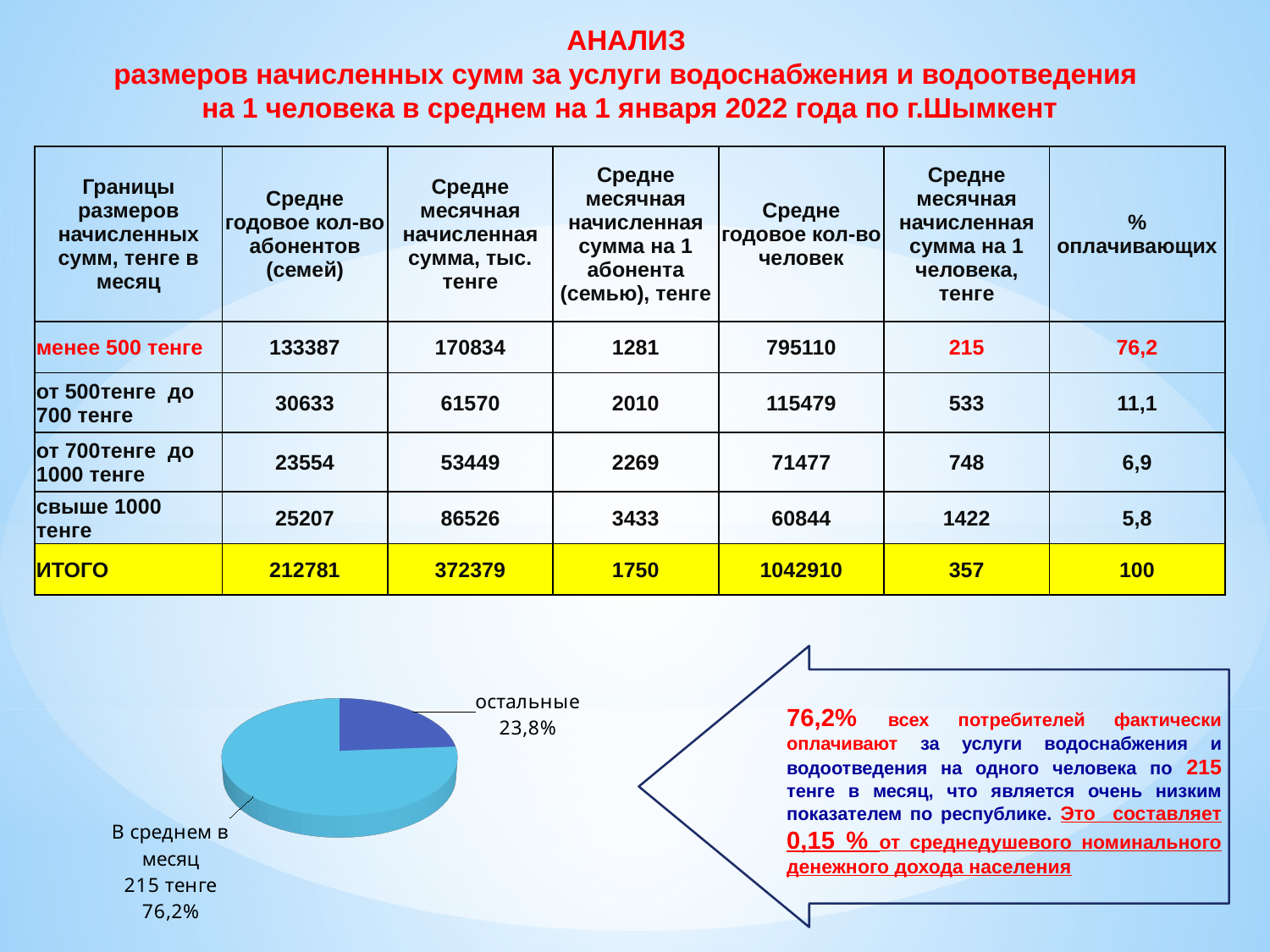
What share of the pie chart is labelled "остальные"? 23,8% What kind of chart is shown at the bottom left of the slide? pie chart What monthly amount in tenge is mentioned in the label of the larger pie slice? 215 тенге How many slices does the pie chart have? 2 Which slice of the pie chart is the largest? В среднем в месяц 215 тенге In the pie chart, which is larger: the "остальные" slice or the "В среднем в месяц 215 тенге" slice? В среднем в месяц 215 тенге Which slice of the pie chart is the smallest? остальные What colour is the "остальные" slice of the pie chart? dark blue What share of the pie chart is labelled "В среднем в месяц 215 тенге"? 76,2% What is the difference in percentage points between the two slices of the pie chart? 52,4 What is the total of the two slice percentages shown on the pie chart? 100%